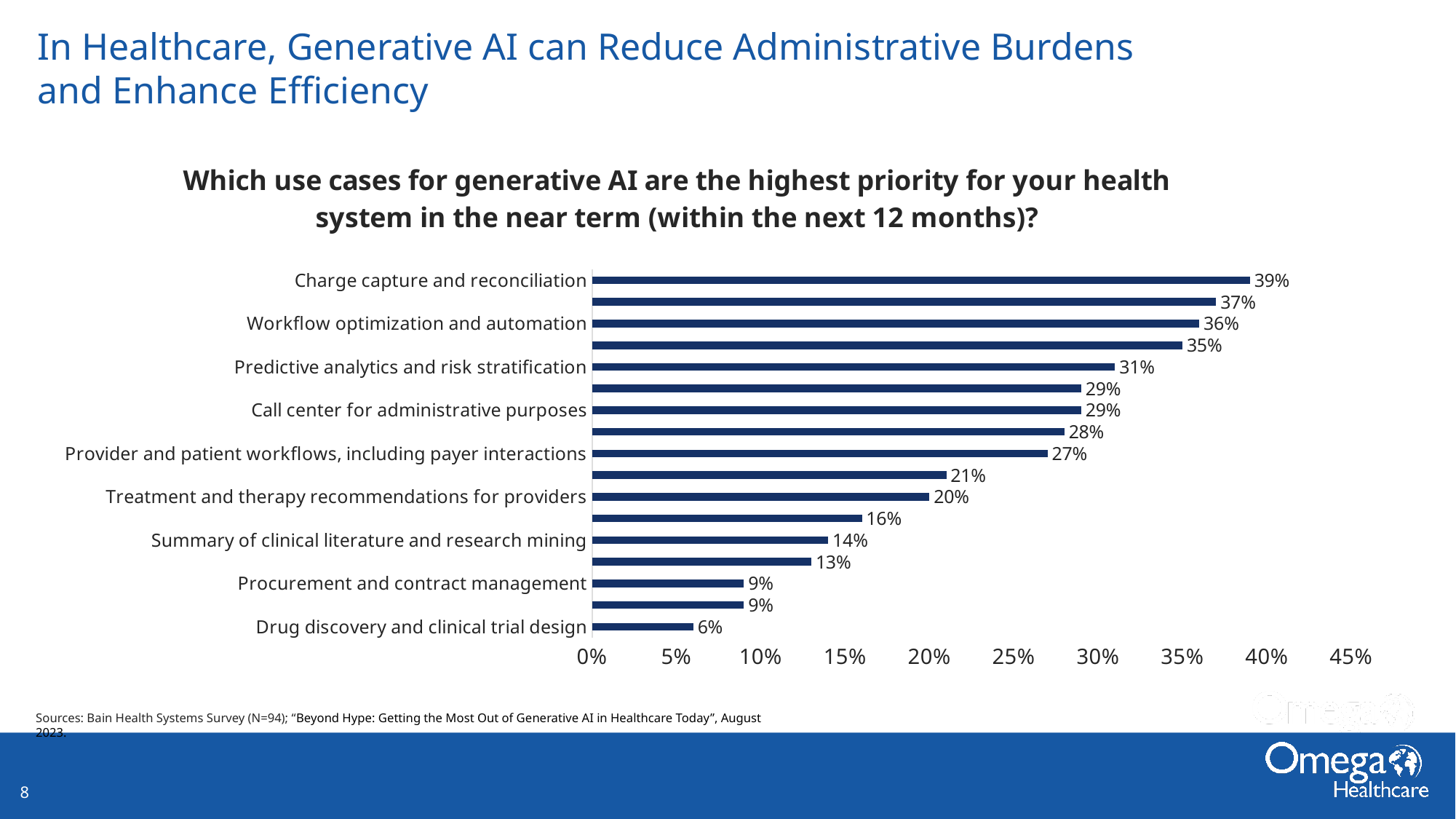
Which is larger, Provider and patient workflows, including payer interactions or Procurement and contract management? Provider and patient workflows, including payer interactions Which labeled use case has the highest value? Charge capture and reconciliation What kind of chart is shown on the slide? bar chart Which labeled use case has the lowest value? Drug discovery and clinical trial design How many bars are plotted in the chart? 17 What is the difference between Charge capture and reconciliation and Drug discovery and clinical trial design? 33% What is the value for Workflow optimization and automation? 36% What is the difference between Call center for administrative purposes and Treatment and therapy recommendations for providers? 9% What is the value for Summary of clinical literature and research mining? 14% What is the value for Charge capture and reconciliation? 39% What is the value for Predictive analytics and risk stratification? 31% Is the value for Predictive analytics and risk stratification greater or less than 30%? greater